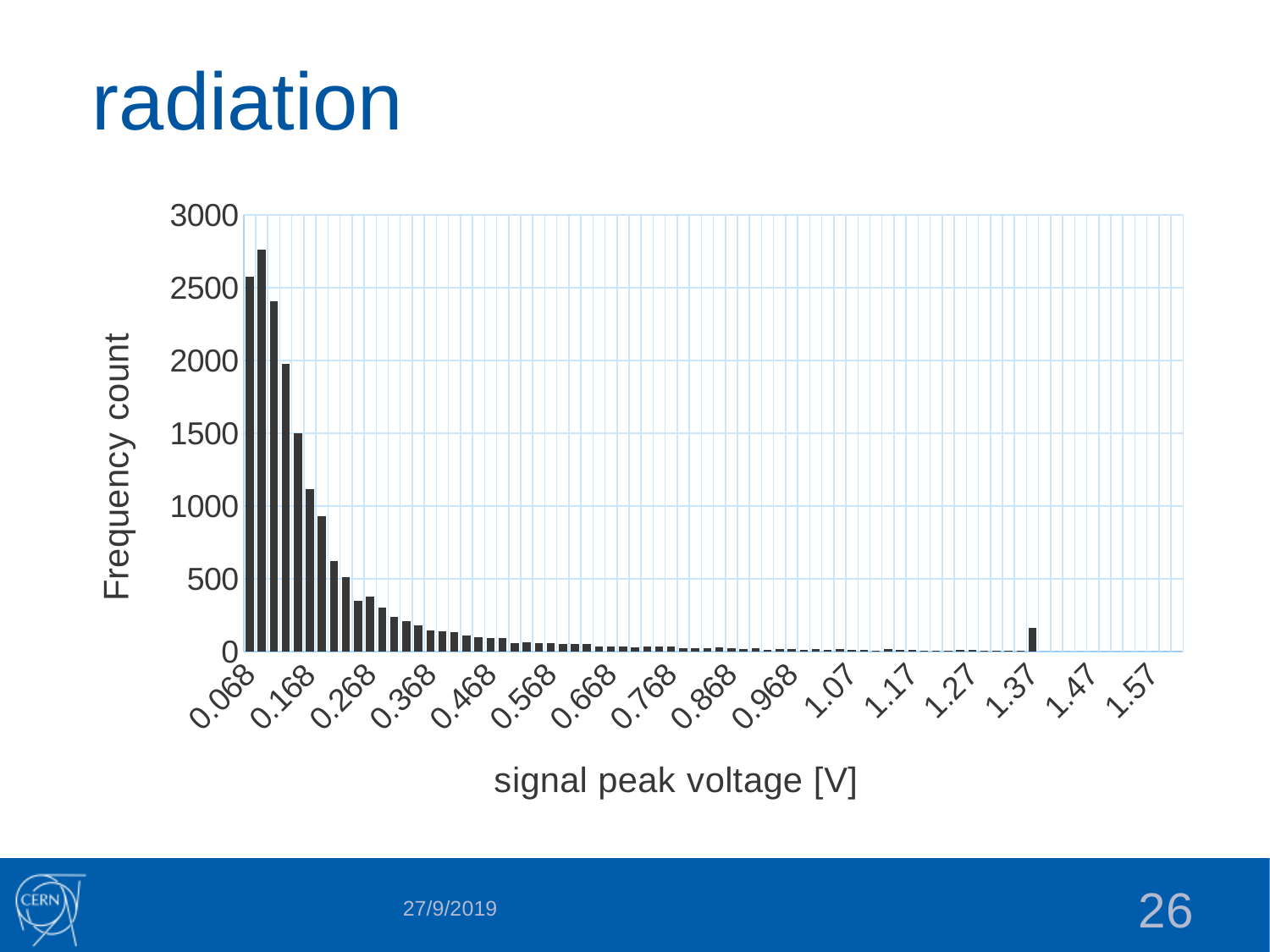
Is the frequency count for 0.068 greater or less than 2000? greater What kind of chart is shown on the slide? bar chart Is the frequency count for 0.568 greater or less than 500? less Is the frequency count for 0.268 greater or less than 500? less What is the title of the vertical axis? Frequency count Which has the larger frequency count, 0.068 or 0.468? 0.068 What is the title of the horizontal axis? signal peak voltage [V] Overall, do the frequency counts rise or fall as the signal peak voltage increases along the x axis? fall